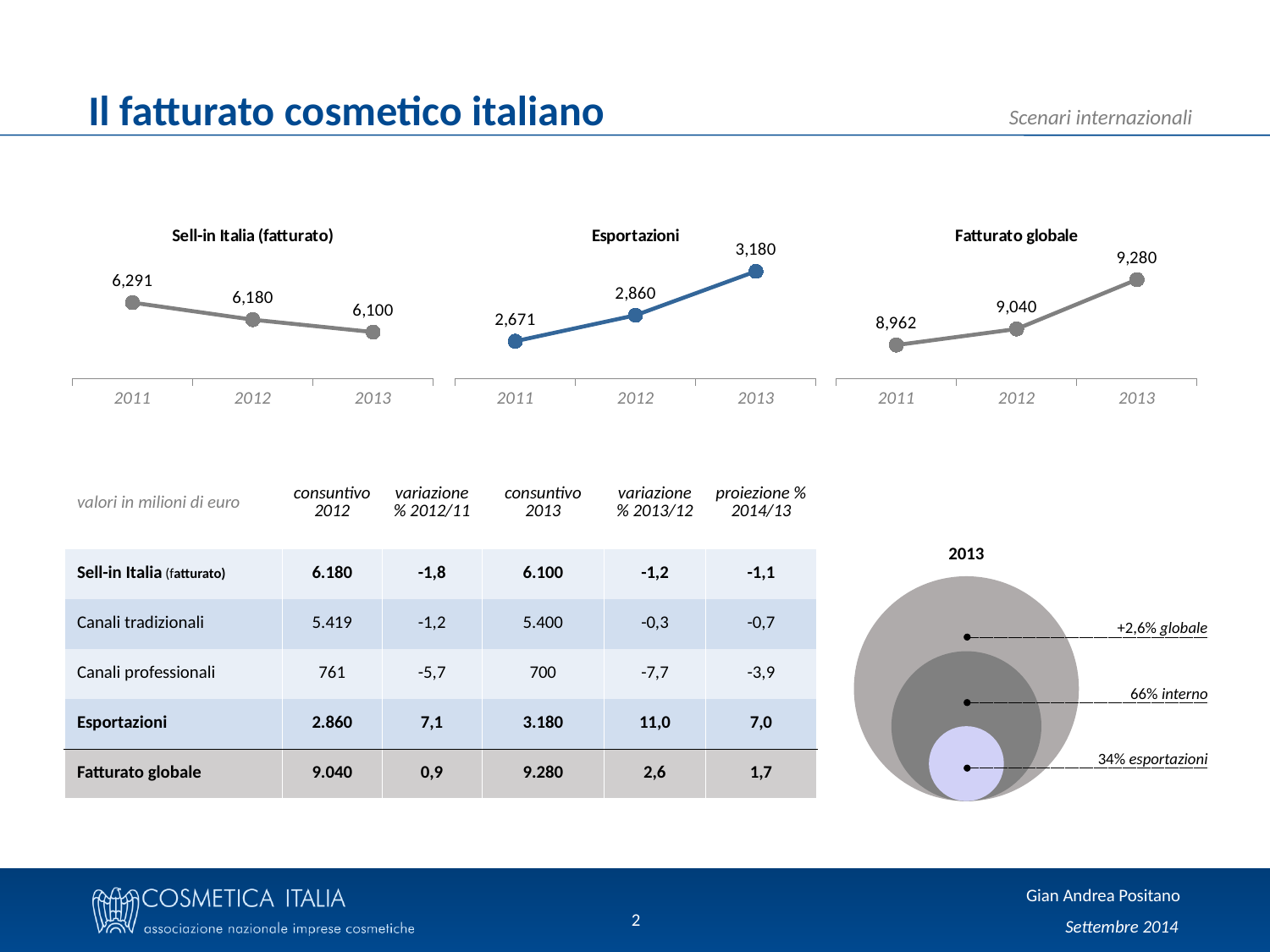
In the 'Esportazioni' chart, what is the value for 2013? 3,180 In the 'Sell-in Italia (fatturato)' chart, what is the value for 2011? 6,291 In the 'Sell-in Italia (fatturato)' chart, which is larger, the value for 2011 or the value for 2013? 2011 In the 'Esportazioni' chart, which year has the highest value? 2013 In the 'Fatturato globale' chart, what is the value for 2012? 9,040 What type of chart is the 'Esportazioni' chart? line chart In the 'Esportazioni' chart, do the values rise or fall from 2011 to 2013? rise In the 'Sell-in Italia (fatturato)' chart, do the values rise or fall from 2011 to 2013? fall In the 'Esportazioni' chart, what is the difference between the 2013 and 2012 values? 320 In the 'Fatturato globale' chart, what is the difference between the 2013 and 2011 values? 318 How many years are plotted in the 'Fatturato globale' chart? 3 In the 'Sell-in Italia (fatturato)' chart, which year has the lowest value? 2013